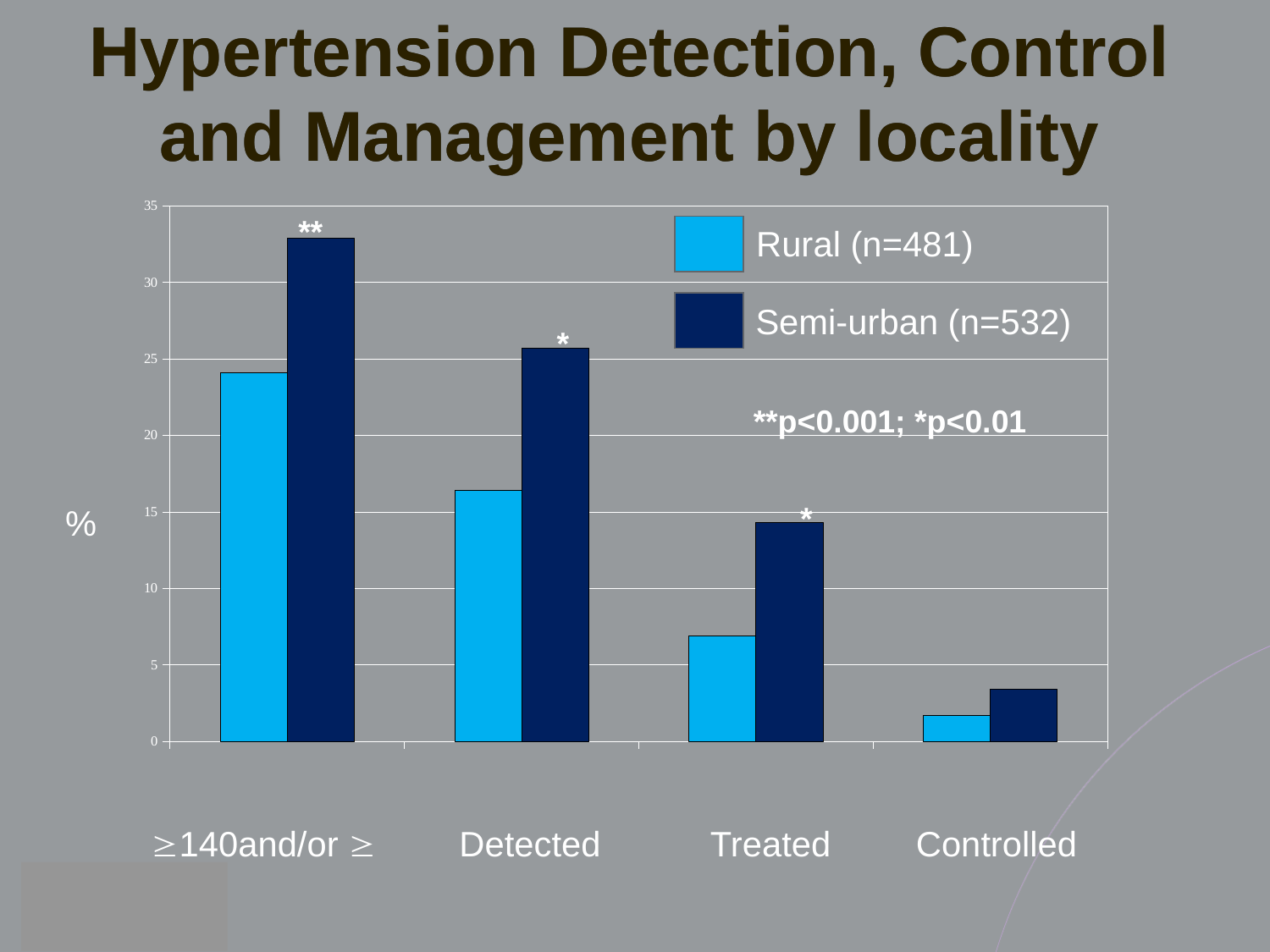
How many categories are shown on the x axis? 4 What kind of chart is shown on the slide? bar chart Which colour represents Semi-urban (n=532) in the legend? dark blue Which is larger for Treated: the Rural (n=481) value or the Semi-urban (n=532) value? Semi-urban (n=532) Which category has the highest Semi-urban (n=532) value? ≥140and/or ≥ Is the Semi-urban (n=532) value for ≥140and/or ≥ greater or less than 30? greater How many series does the legend list? 2 Which category has the lowest Rural (n=481) value? Controlled Is the Rural (n=481) value for Controlled greater or less than 5? less Is the Semi-urban (n=532) value for Treated greater or less than 10? greater Do the Rural (n=481) values rise or fall moving from ≥140and/or ≥ to Controlled along the x axis? fall